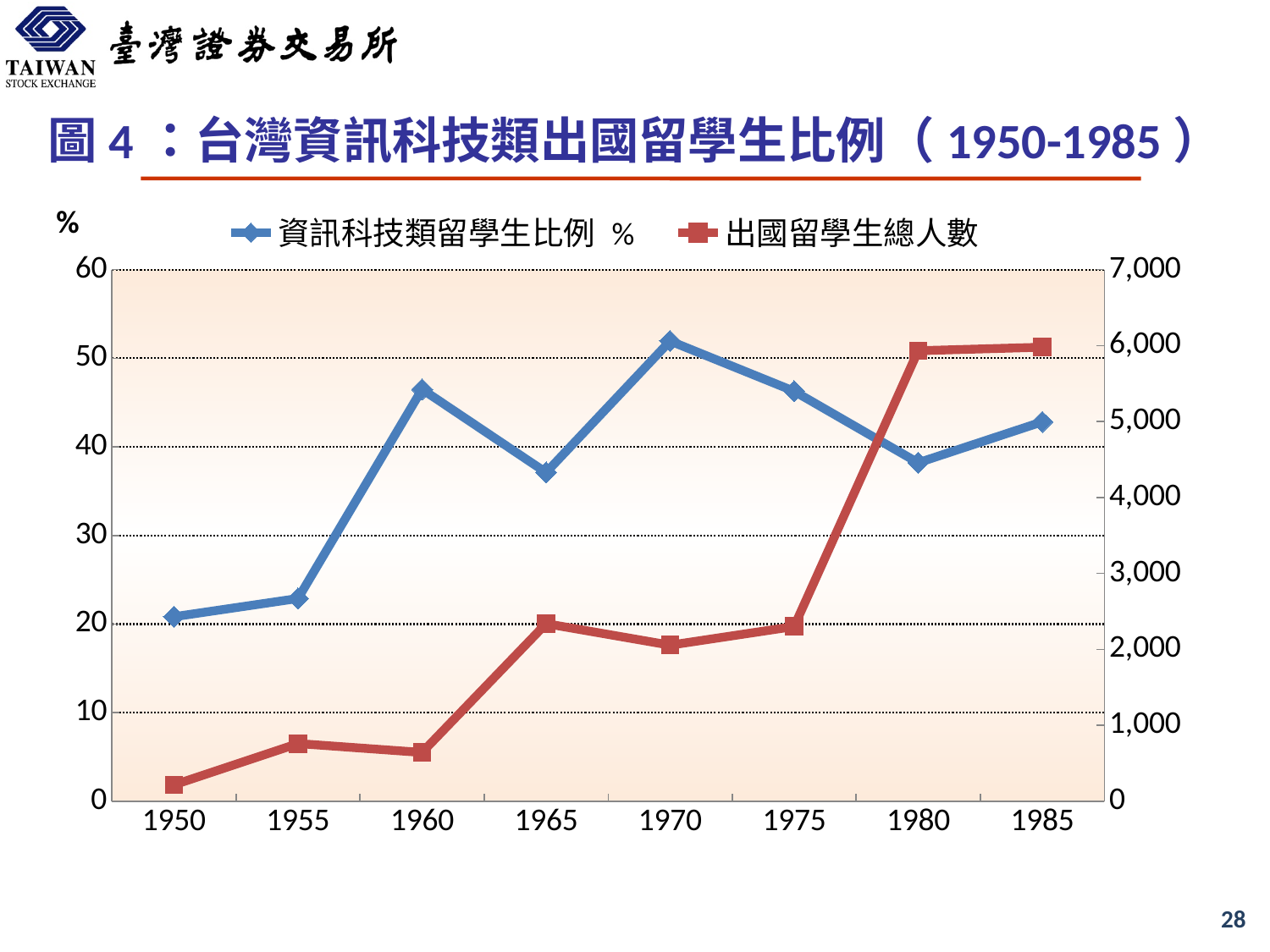
In which year does the 資訊科技類留學生比例 % series reach its highest value? 1970 How many years are plotted along the x axis? 8 Which year has the larger value for 資訊科技類留學生比例 %, 1960 or 1965? 1960 Is the value for 出國留學生總人數 in 1950 greater or less than 1,000? less Which colour is used for the 出國留學生總人數 series? red Is the value for 出國留學生總人數 in 1980 greater or less than 5,000? greater How many series does the legend list? 2 Is the value for 資訊科技類留學生比例 % in 1965 greater or less than 40? less In which year is the 出國留學生總人數 series at its lowest? 1950 Does the 出國留學生總人數 series rise or fall overall from 1950 to 1985? rise What kind of chart is shown on the slide? line chart